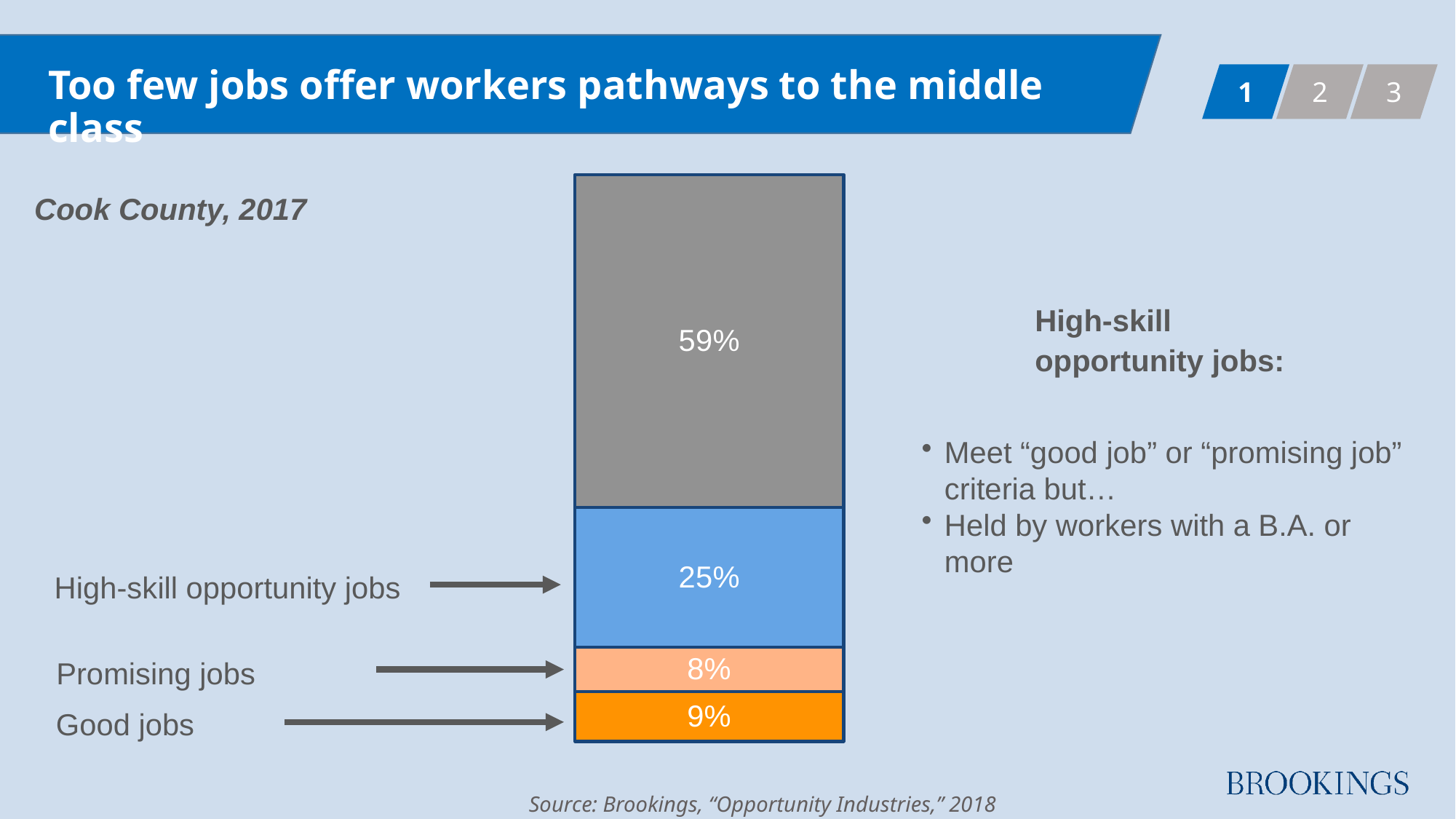
Which is larger, the share of Good jobs or the share of Promising jobs? Good jobs What colour is the Good jobs segment of the bar? Orange How many segments make up the stacked bar? 4 Which of the three labeled segments has the largest share? High-skill opportunity jobs What is the combined share of Good jobs, Promising jobs and High-skill opportunity jobs? 42% What kind of chart is shown on the slide? Stacked bar chart What is the difference between the share of High-skill opportunity jobs and the share of Good jobs? 16% What value is printed on the gray segment at the top of the bar? 59% Which of the three labeled segments has the smallest share? Promising jobs What percentage of jobs are Promising jobs? 8% What percentage of jobs are Good jobs? 9% What percentage of jobs are High-skill opportunity jobs? 25%